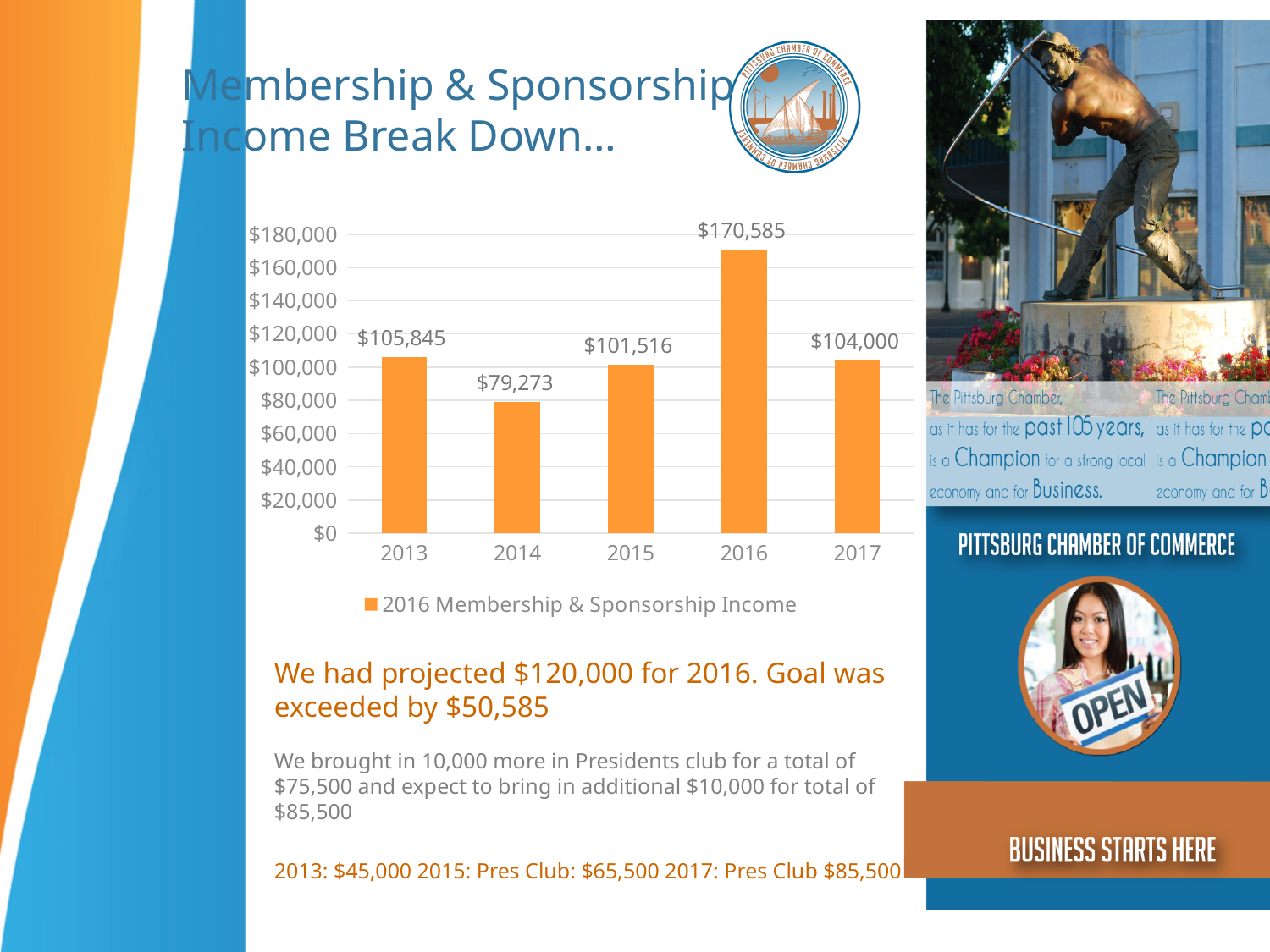
What series name does the legend show? 2016 Membership & Sponsorship Income Which year has the lowest value? 2014 What is the difference between the values for 2016 and 2017? $66,585 How many years are shown on the x axis? 5 Is the value for 2014 greater or less than $100,000? less Which year has the highest value? 2016 What is the value for 2014? $79,273 What is the value for 2013? $105,845 What is the value for 2016? $170,585 Which is larger, the value for 2015 or the value for 2017? 2017 What is the difference between the values for 2013 and 2015? $4,329 What kind of chart is shown? bar chart